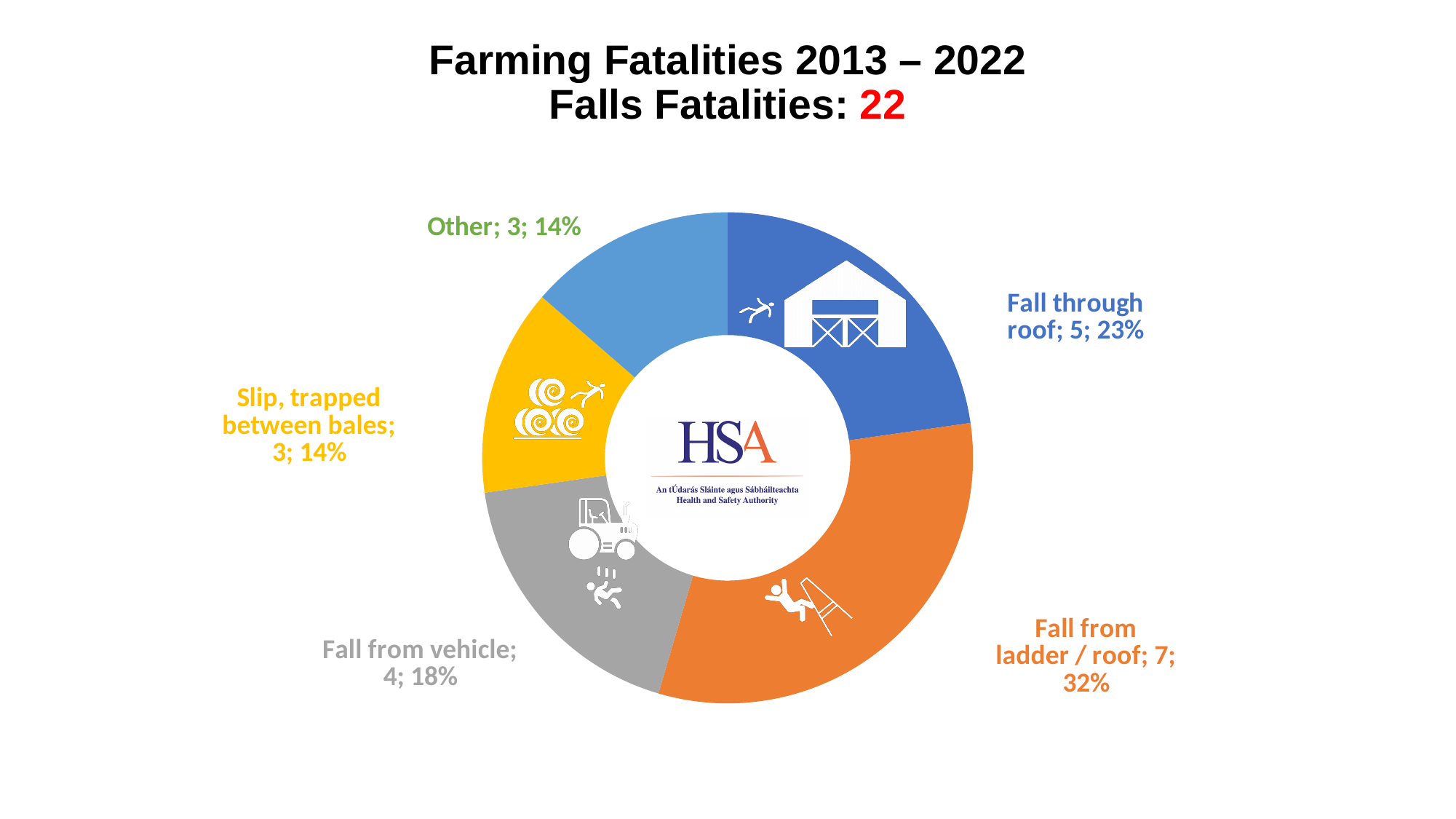
How many falls fatalities does the chart title report in total? 22 How many fatalities are attributed to 'Fall from ladder / roof'? 7 What percentage share does 'Fall through roof' have? 23% How many fatalities are attributed to 'Fall from vehicle'? 4 What is the difference in fatalities between 'Fall from ladder / roof' and 'Fall through roof'? 2 What colour is the 'Fall from vehicle' slice? Grey What is the title of the chart? Farming Fatalities 2013 – 2022 Falls Fatalities: 22 Which has more fatalities, 'Fall from vehicle' or 'Other'? Fall from vehicle What percentage share does 'Slip, trapped between bales' have? 14% How many categories are shown in the chart? 5 What kind of chart is shown on the slide? Pie chart (doughnut) Which category has the highest number of fatalities? Fall from ladder / roof